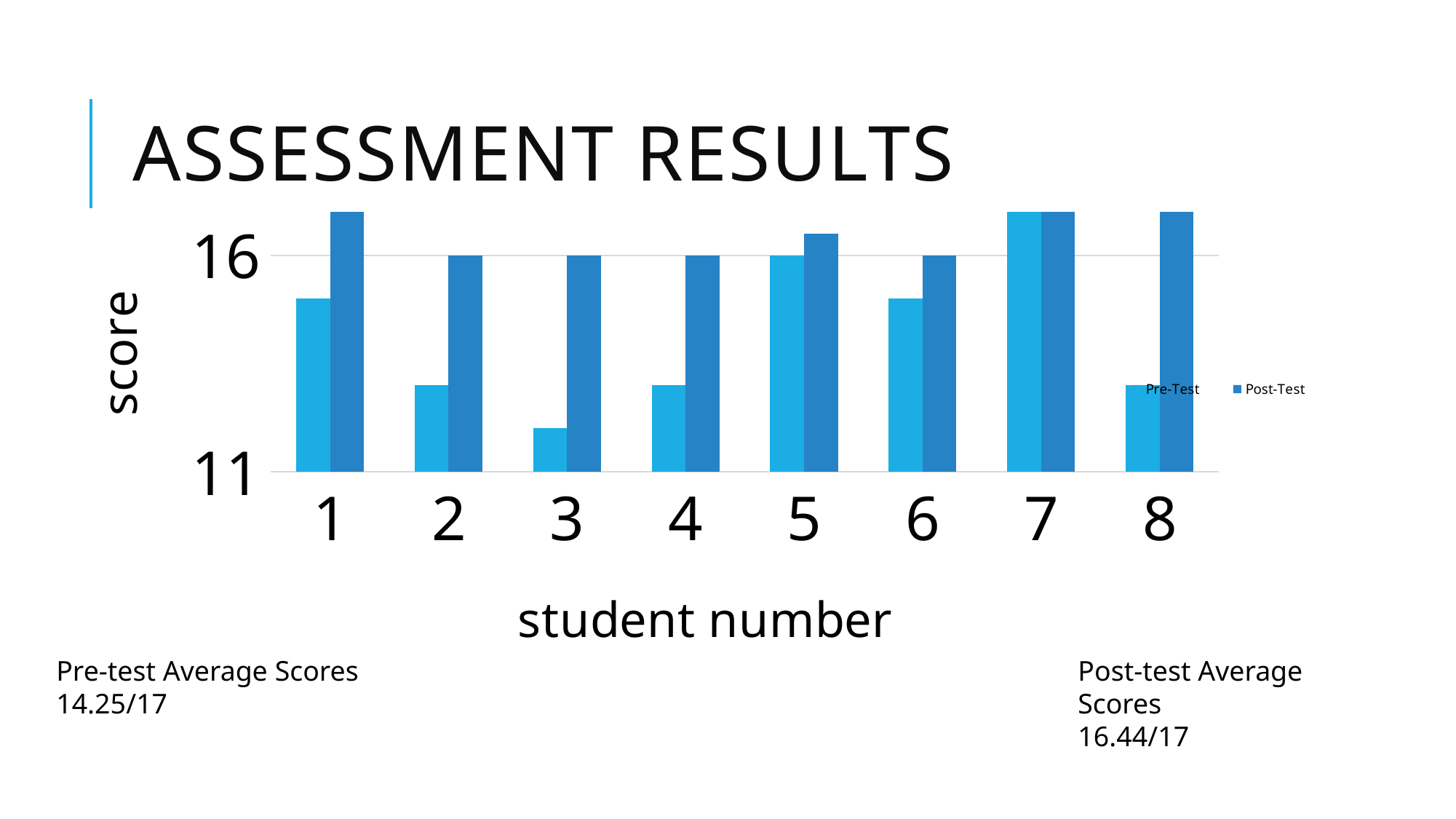
How many series does the legend list? 2 Which student has the lowest Pre-Test score? 3 What is the Post-Test score for student 2? 16 What is the Pre-Test score for student 5? 16 Which student has the highest Pre-Test score? 7 For student 1, which is larger, the Pre-Test or the Post-Test score? Post-Test What is the Post-Test score for student 4? 16 How many student numbers are shown on the x axis? 8 What is the label on the x axis of the chart? student number Is the Pre-Test value for student 3 greater or less than 16? less Is the Post-Test value for student 8 greater or less than 16? greater What kind of chart is shown on the slide? bar chart